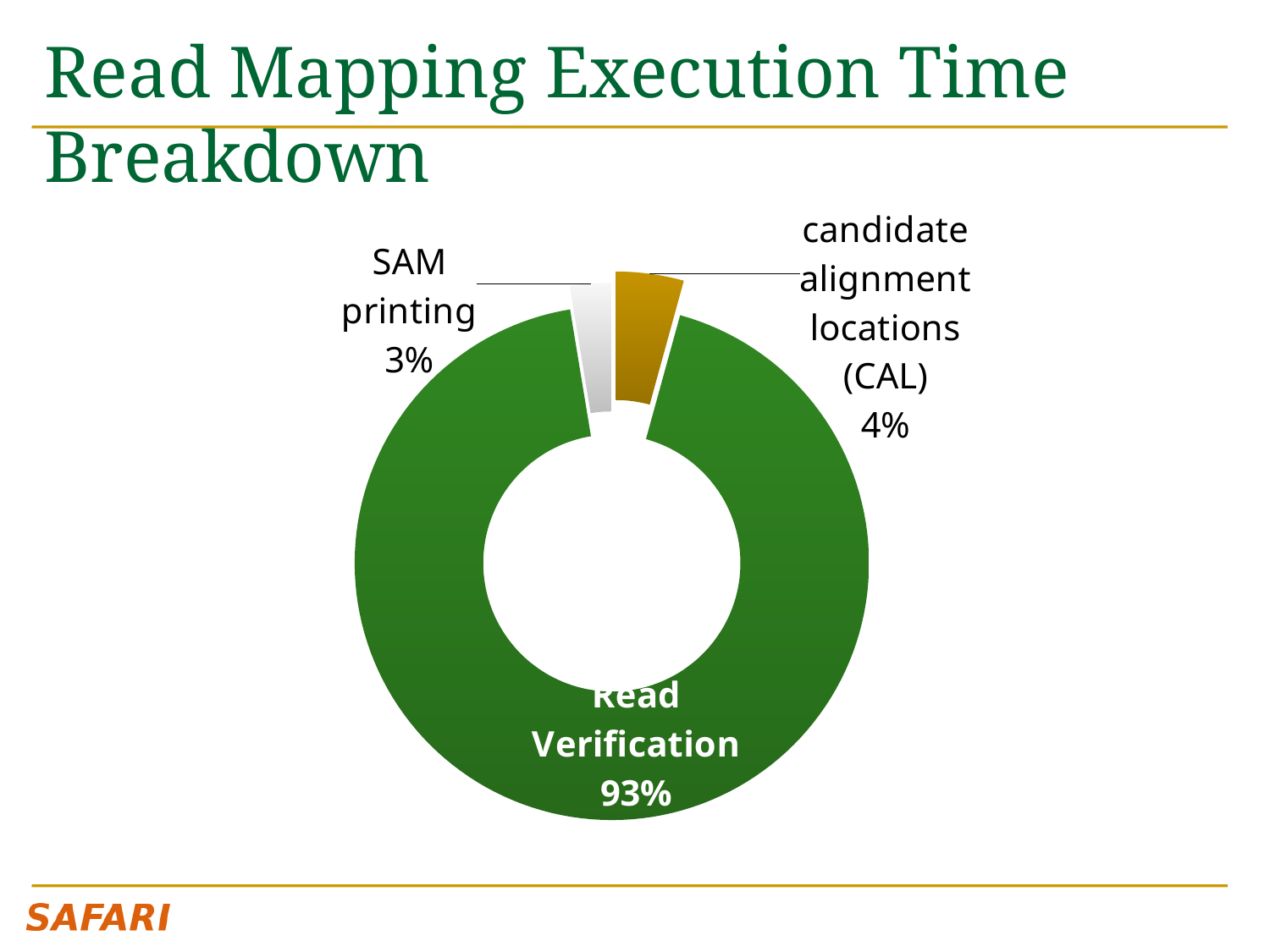
What is the difference in percentage points between candidate alignment locations (CAL) and SAM printing? 1 What is the difference in percentage points between Read Verification and candidate alignment locations (CAL)? 89 What share of execution time is taken by SAM printing? 3% Which takes a larger share of execution time, SAM printing or candidate alignment locations (CAL)? candidate alignment locations (CAL) Which stage takes the largest share of read mapping execution time? Read Verification What colour is the Read Verification segment? Green Which stage takes the smallest share of read mapping execution time? SAM printing What is the title of the slide? Read Mapping Execution Time Breakdown What kind of chart is shown on the slide? Doughnut (pie) chart How many stages are shown in the chart? 3 What share of execution time is taken by candidate alignment locations (CAL)? 4% What share of read mapping execution time is taken by Read Verification? 93%